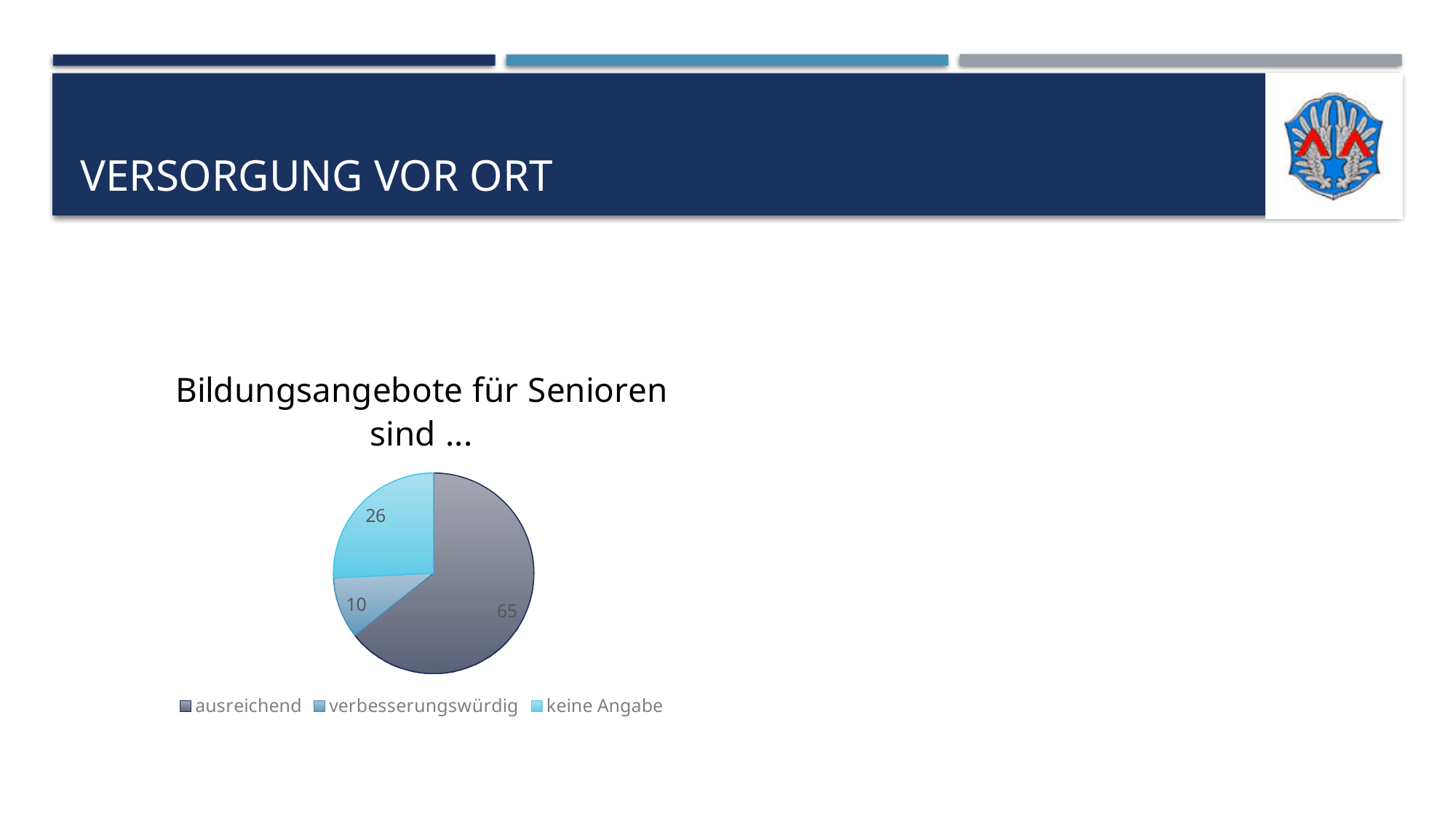
How many categories does the pie chart have? 3 What type of chart is shown on the slide? pie chart What is the total of all slices in the pie chart? 101 What is the difference between the values for "keine Angabe" and "verbesserungswürdig"? 16 What is the difference between the values for "ausreichend" and "keine Angabe"? 39 What is the value for "ausreichend"? 65 What is the value for "keine Angabe"? 26 What is the value for "verbesserungswürdig"? 10 What is the title of the chart? Bildungsangebote für Senioren sind … Which category has the largest slice? ausreichend Which is larger, the value for "keine Angabe" or the value for "verbesserungswürdig"? keine Angabe Which category has the smallest slice? verbesserungswürdig